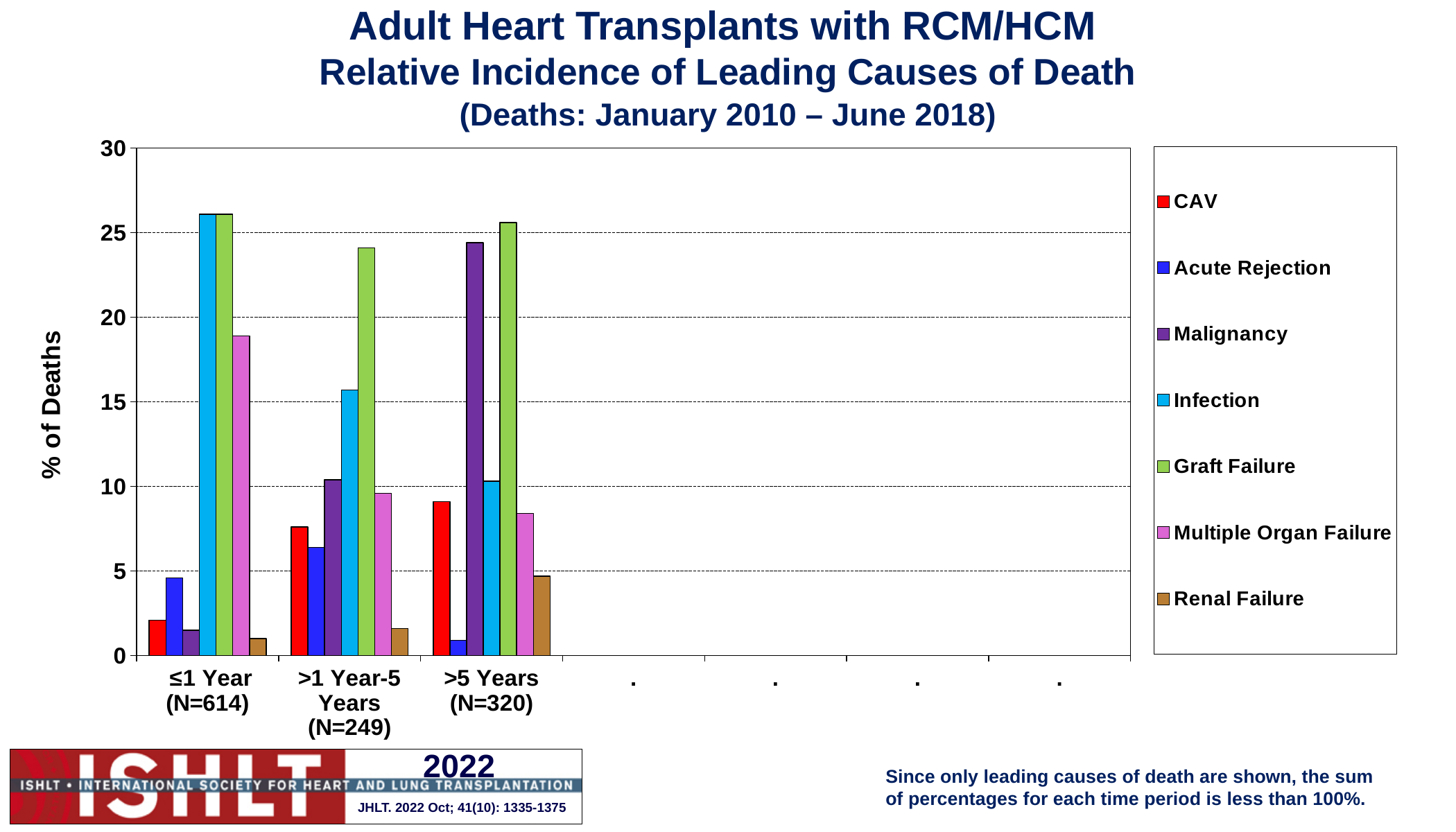
Is the value for Multiple Organ Failure in the ≤1 Year (N=614) group greater or less than 15? greater In the >1 Year-5 Years (N=249) group, which is larger: Infection or Malignancy? Infection How many labeled time-period categories are shown on the x axis? 3 Does the value for Infection rise or fall across the time periods from ≤1 Year to >5 Years? Fall Is the value for Malignancy in the >5 Years (N=320) group greater or less than 20? greater What kind of chart is shown on the slide? Bar chart Which cause of death has the lowest value in the >5 Years (N=320) group? Acute Rejection Which cause of death has the highest value in the >1 Year-5 Years (N=249) group? Graft Failure What is the label on the y axis? % of Deaths Does the value for CAV rise or fall across the time periods from ≤1 Year to >5 Years? Rise Is the value for Infection in the ≤1 Year (N=614) group greater or less than 20? greater How many series does the legend list? 7